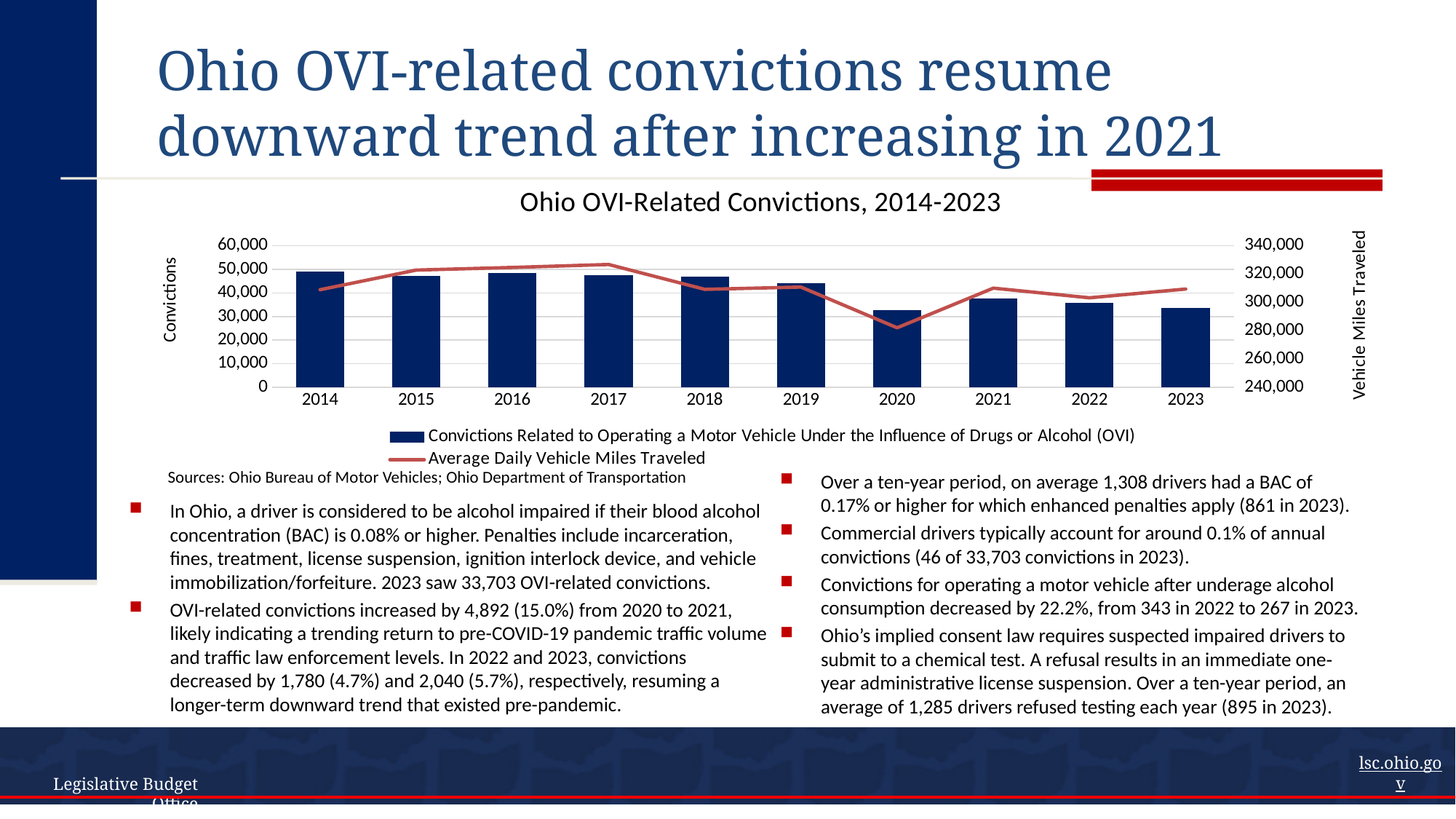
Which year has the lowest number of OVI-related convictions? 2020 How many series does the chart legend list? 2 Is the Average Daily Vehicle Miles Traveled in 2020 greater or less than 300,000? less Do OVI-related convictions rise or fall from 2021 to 2023? fall What kind of chart is used to show the OVI convictions series? Bar chart In which year does the Average Daily Vehicle Miles Traveled line reach its lowest point? 2020 How many years are shown on the x axis of the chart? 10 Is the number of OVI-related convictions in 2020 greater or less than 40,000? less Which year had more OVI-related convictions, 2019 or 2020? 2019 Is the number of OVI-related convictions in 2014 greater or less than 40,000? greater In which year does the Average Daily Vehicle Miles Traveled line reach its highest point? 2017 What is the title of the chart? Ohio OVI-Related Convictions, 2014-2023